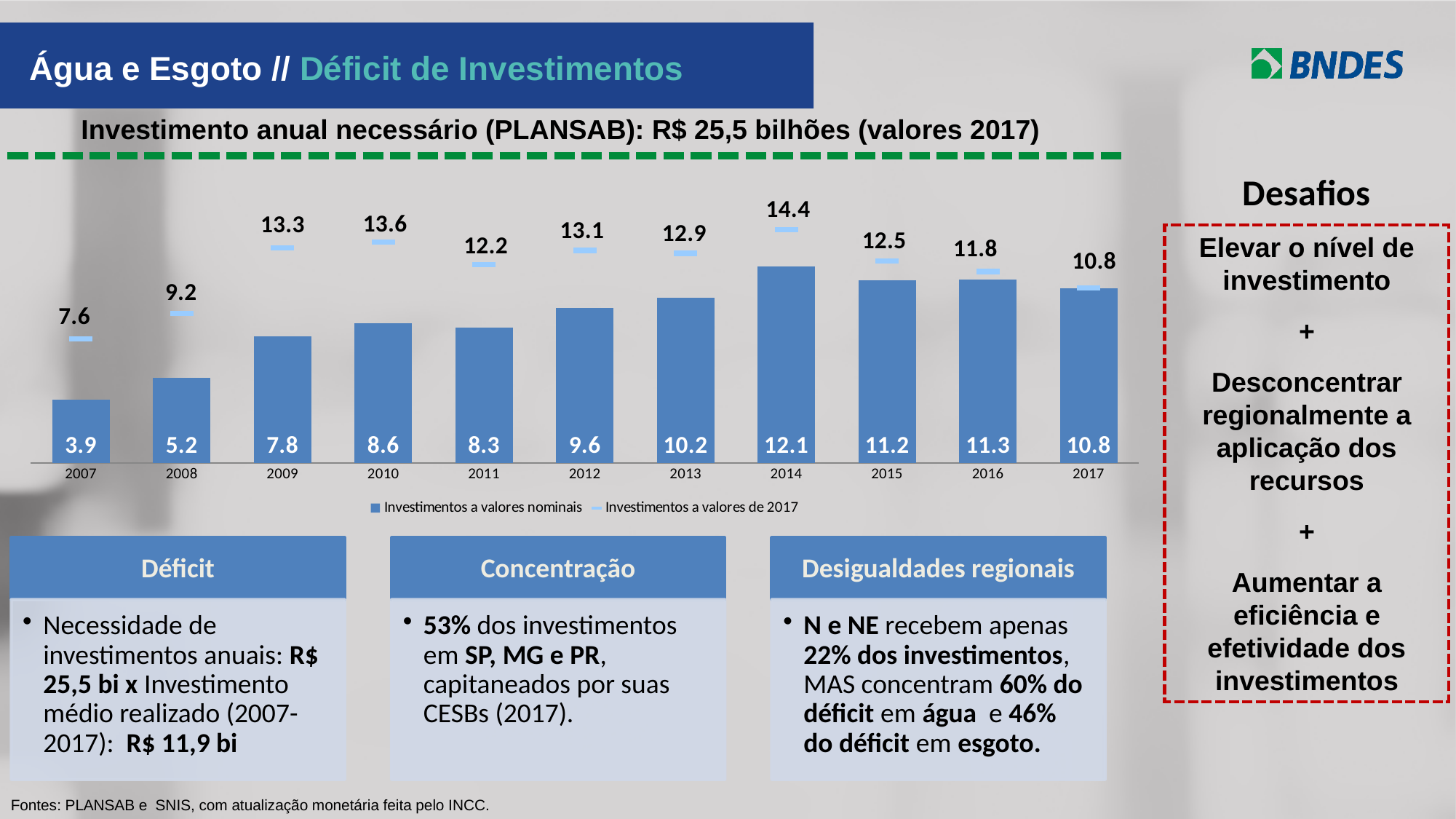
What is the value of 'Investimentos a valores de 2017' for 2009? 13.3 What is the value of 'Investimentos a valores nominais' for 2014? 12.1 What is the name of the second series listed in the chart legend? Investimentos a valores de 2017 What kind of chart is used to show 'Investimentos a valores nominais'? bar chart What is the difference between the 'Investimentos a valores nominais' values for 2014 and 2007? 8.2 How many series does the chart legend list? 2 Which is larger: the 'Investimentos a valores nominais' value for 2015 or for 2016? 2016 Do the 'Investimentos a valores nominais' values rise or fall from 2007 to 2010? rise How many years are shown on the x axis of the chart? 11 Which year has the lowest value for 'Investimentos a valores de 2017'? 2007 Which year has the highest value for 'Investimentos a valores nominais'? 2014 What is the difference between the 'Investimentos a valores de 2017' and 'Investimentos a valores nominais' values for 2007? 3.7